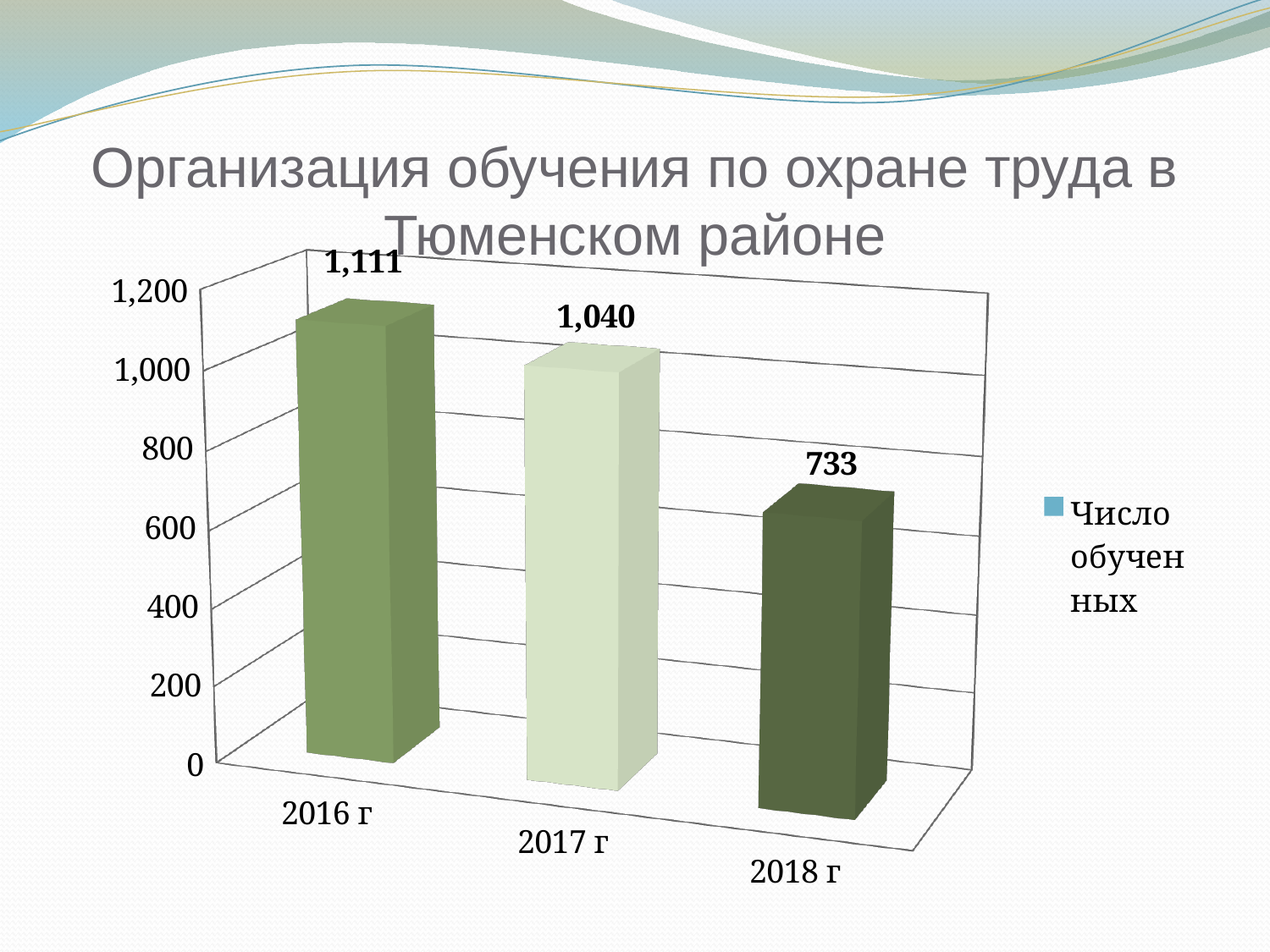
What is the value for 2016 г? 1,111 What is the difference between the values for 2016 г and 2017 г? 71 What is the value for 2017 г? 1,040 What is the difference between the values for 2016 г and 2018 г? 378 What kind of chart is shown on the slide? bar chart Which is larger, the value for 2017 г or the value for 2018 г? 2017 г Is the value for 2018 г greater or less than 800? less Do the values rise or fall from 2016 г to 2018 г? fall What is the value for 2018 г? 733 How many categories are shown on the x axis? 3 Which year has the lowest value? 2018 г Which year has the highest value? 2016 г